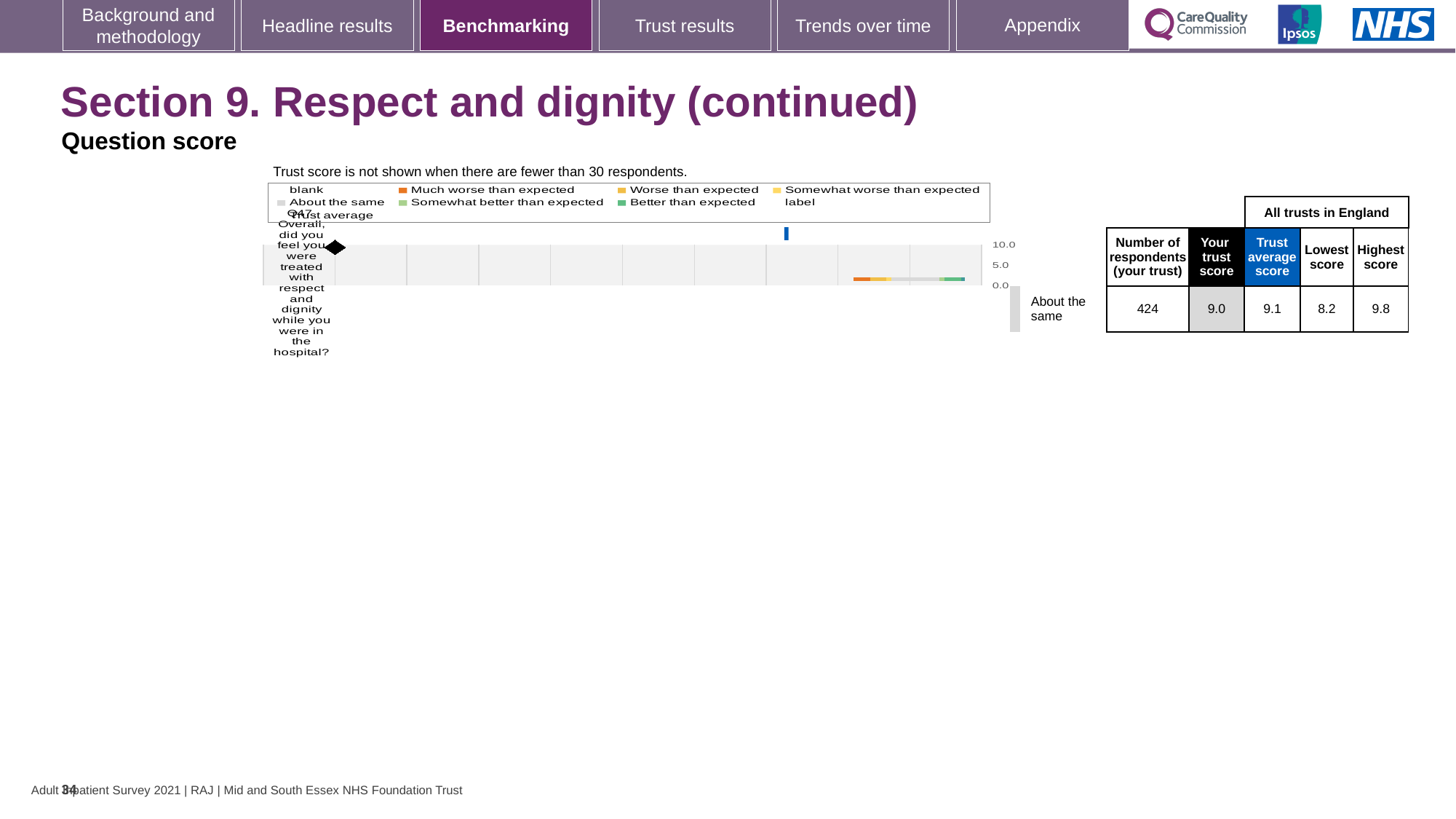
What is the maximum value shown on the chart's score axis? 10.0 What is the trust average score for Q47? 9.1 Which is larger for Q47: your trust score or the trust average score? Trust average score What is the lowest score among all trusts in England for Q47? 8.2 What kind of chart is shown on the slide? Bar chart What is the highest score among all trusts in England for Q47? 9.8 What is the number of respondents (your trust) shown for Q47? 424 What is the 'Your trust score' value for Q47? 9.0 What is the difference between the highest and lowest scores for Q47? 1.6 Is the trust score for Q47 greater or less than 5.0? greater How many questions are plotted on the chart? 1 How is the trust's result for Q47 categorised relative to expectations? About the same